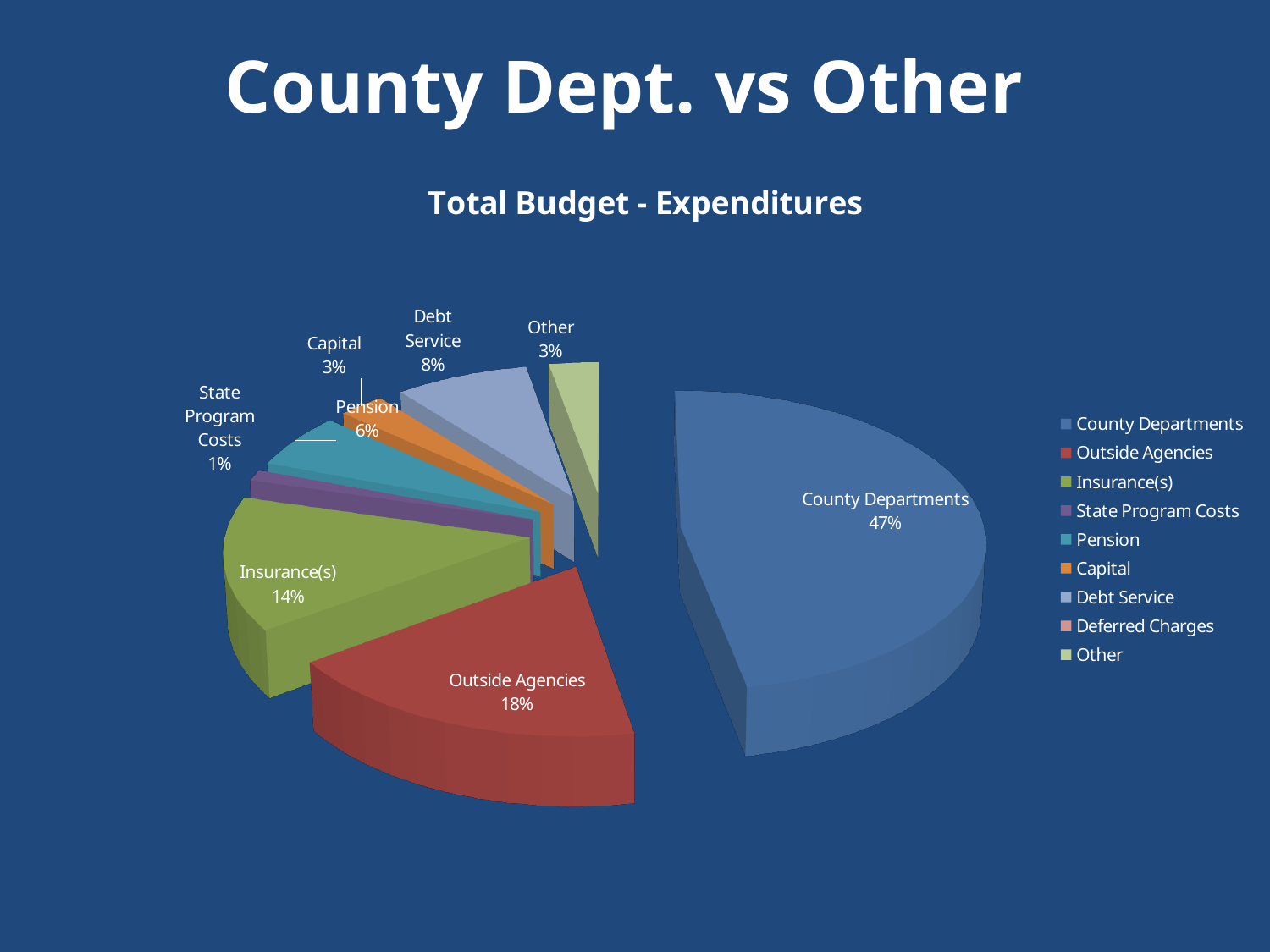
What share of the pie is State Program Costs? 1% What is the title of the chart? Total Budget - Expenditures What share of the pie is County Departments? 47% Which labelled category has the smallest slice of the pie? State Program Costs What share of the pie is Outside Agencies? 18% How many entries does the legend list? 9 What is the difference in percentage points between County Departments and Outside Agencies? 29 What type of chart is shown on the slide? Pie chart Which category has the largest slice of the pie? County Departments